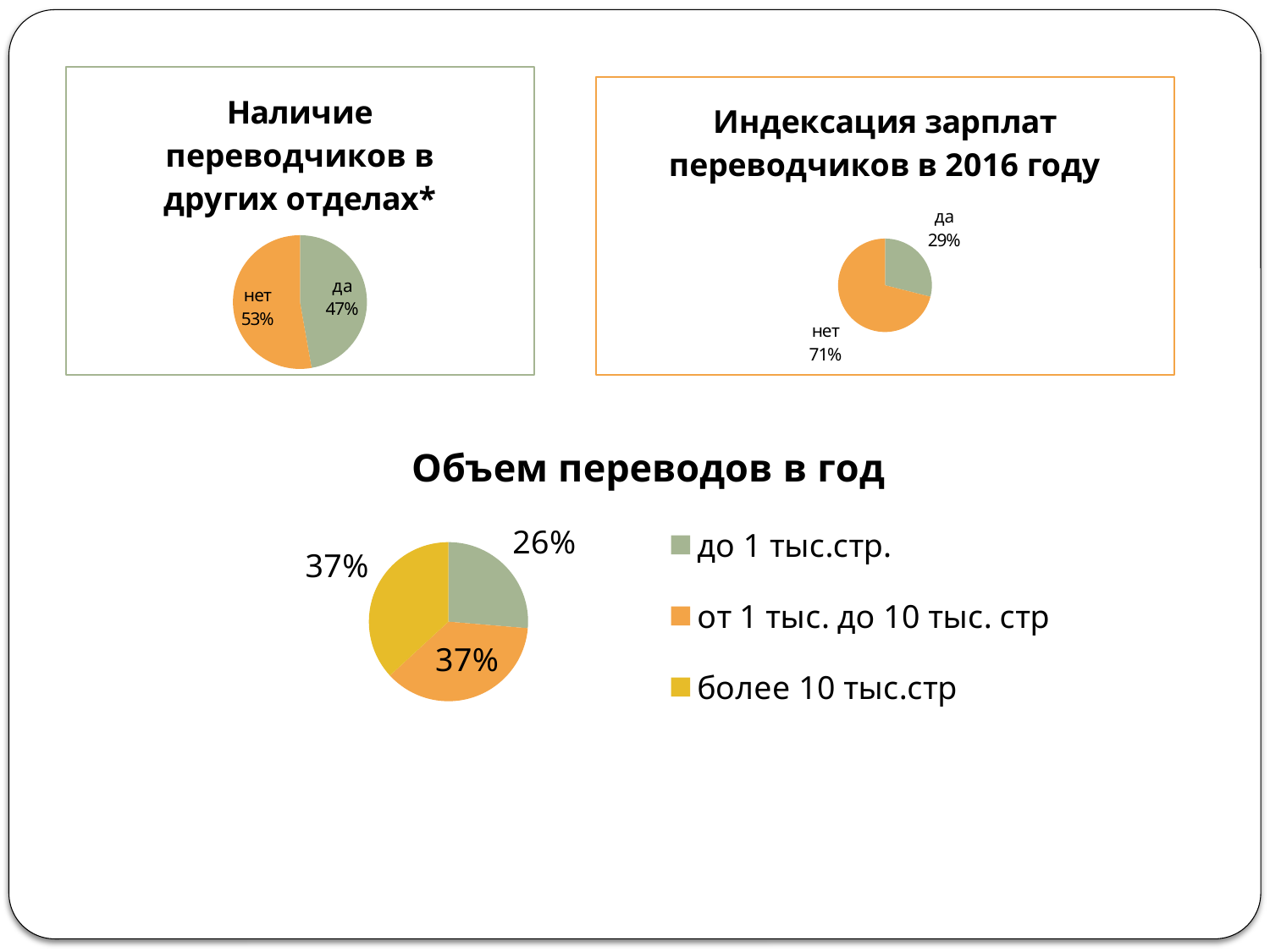
In the chart 'Объем переводов в год', which category has the smallest share? до 1 тыс.стр. In the chart 'Наличие переводчиков в других отделах*', which slice is larger, 'да' or 'нет'? нет In the chart 'Индексация зарплат переводчиков в 2016 году', what is the difference between the 'нет' and 'да' shares? 42% In the chart 'Наличие переводчиков в других отделах*', what share is labelled 'да'? 47% In the chart 'Объем переводов в год', what share corresponds to 'более 10 тыс.стр'? 37% In the chart 'Объем переводов в год', what colour is the slice for 'от 1 тыс. до 10 тыс. стр'? orange In the chart 'Индексация зарплат переводчиков в 2016 году', what share is labelled 'нет'? 71% In the chart 'Индексация зарплат переводчиков в 2016 году', what share is labelled 'да'? 29% What kind of chart is 'Объем переводов в год'? pie chart In the chart 'Наличие переводчиков в других отделах*', what share is labelled 'нет'? 53% In the chart 'Объем переводов в год', what share corresponds to 'до 1 тыс.стр.'? 26% How many categories does the legend of the chart 'Объем переводов в год' list? 3